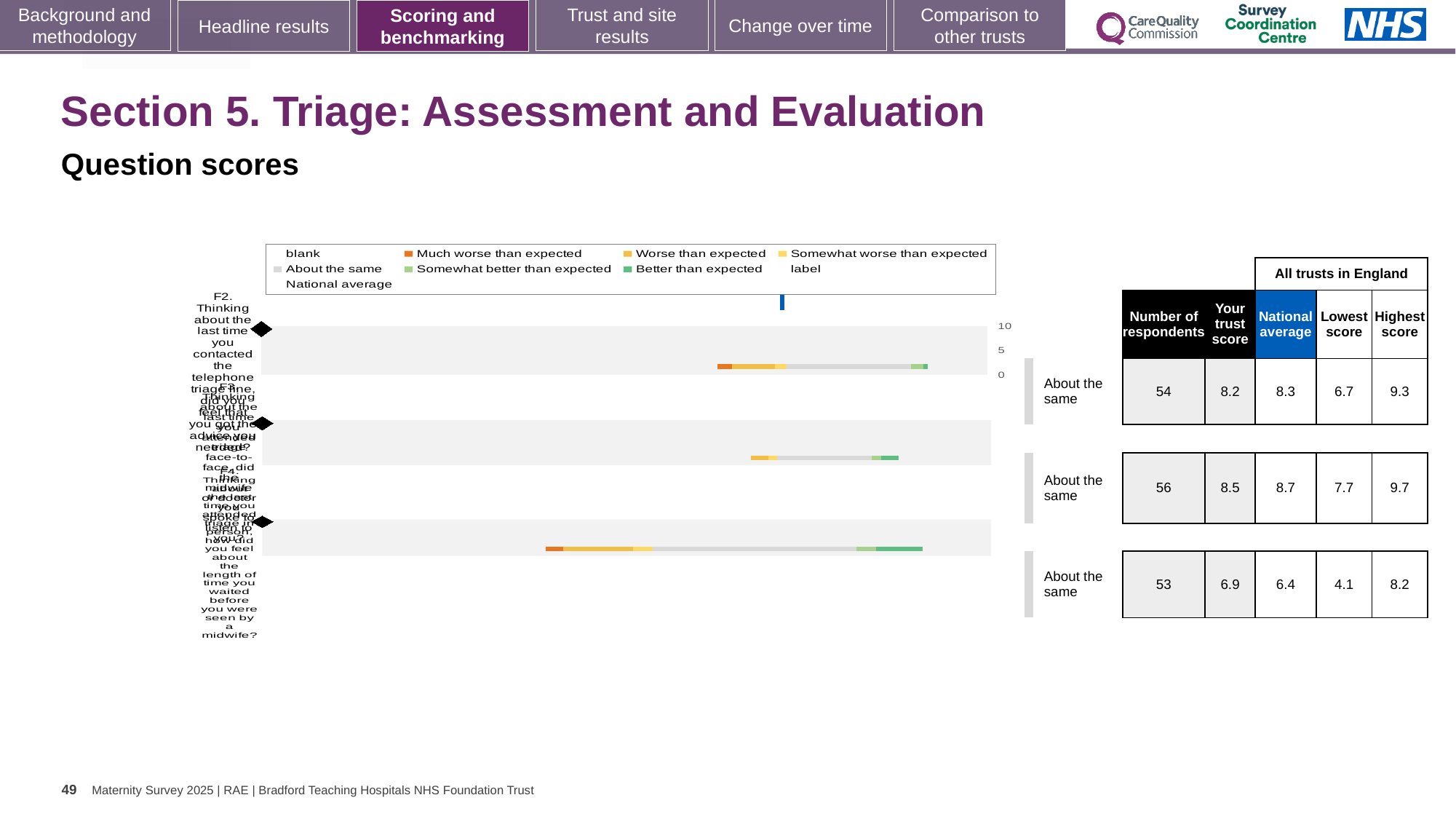
In the table beside the chart, is the trust score or the national average larger for the second row? national average In the table beside the chart, what is the national average for the third row? 6.4 What colour does the legend use for 'Better than expected'? green How many entries does the chart legend list? 9 What benchmark category is shown next to each of the three chart rows? About the same In the table beside the chart, what is the 'Your trust score' for the first row? 8.2 In the table beside the chart, which row has the lowest 'Lowest score' value? the third row (4.1) How many question rows (bars) are plotted in the chart? 3 In the table beside the chart, what is the difference between the highest score and the lowest score for the third row? 4.1 What kind of chart is shown on the slide? bar chart In the table beside the chart, which row has the highest number of respondents? the second row (56) What colour does the legend use for 'Much worse than expected'? orange